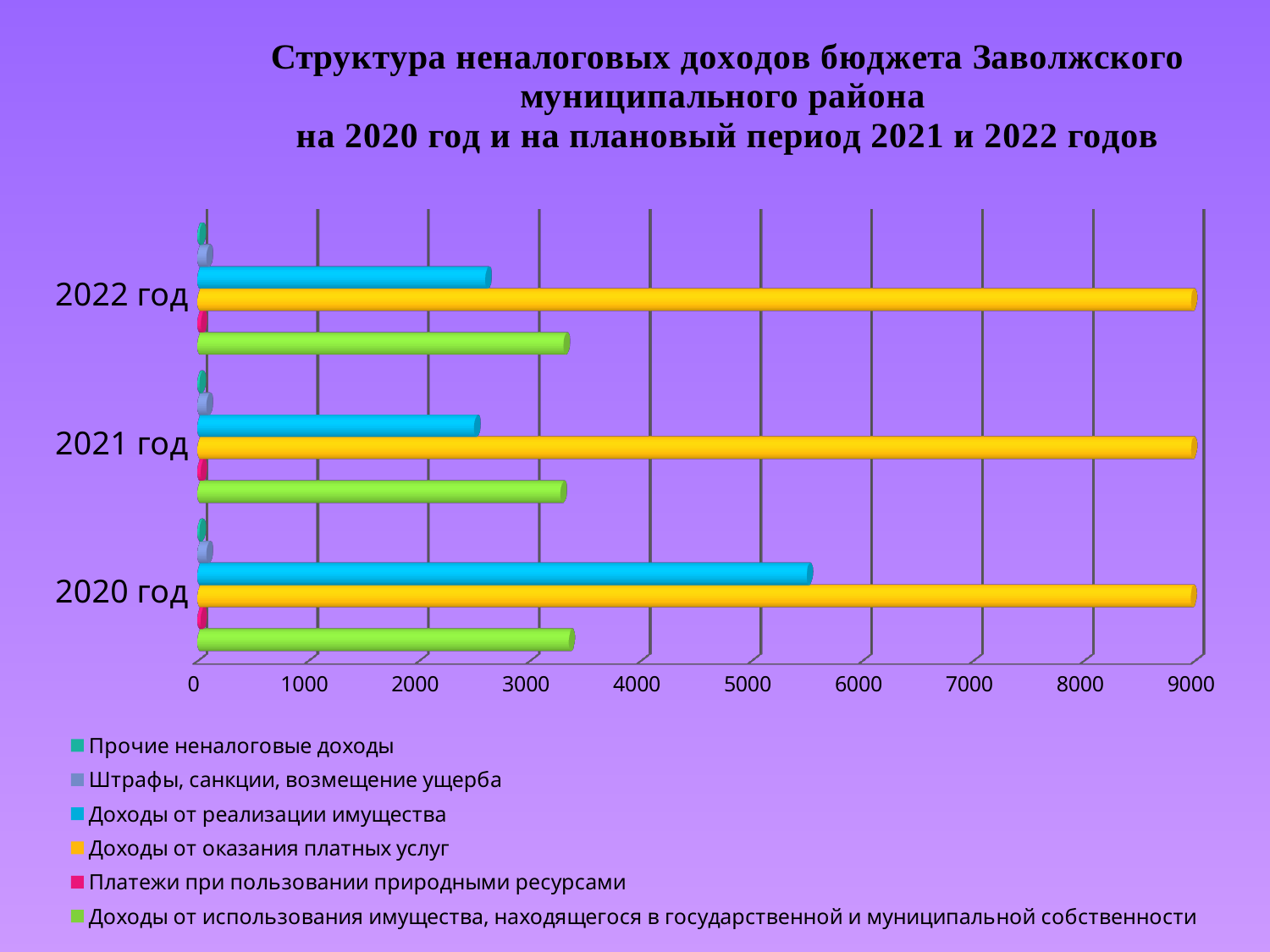
Which year has the larger value for Доходы от реализации имущества, 2020 год or 2022 год? 2020 год Is the value for Доходы от реализации имущества in 2021 год greater or less than 3000? less How many year categories are shown on the chart? 3 Is the value for Доходы от оказания платных услуг in 2022 год greater or less than 8000? greater Which series has the highest value in 2020 год? Доходы от оказания платных услуг In 2021 год, which is larger: Доходы от реализации имущества or Доходы от использования имущества, находящегося в государственной и муниципальной собственности? Доходы от использования имущества, находящегося в государственной и муниципальной собственности Does the value for Доходы от реализации имущества rise or fall from 2020 год to 2021 год? fall How many series does the legend list? 6 Is the value for Доходы от реализации имущества in 2020 год greater or less than 5000? greater What colour represents Доходы от оказания платных услуг in the legend? yellow What kind of chart is shown on the slide? bar chart